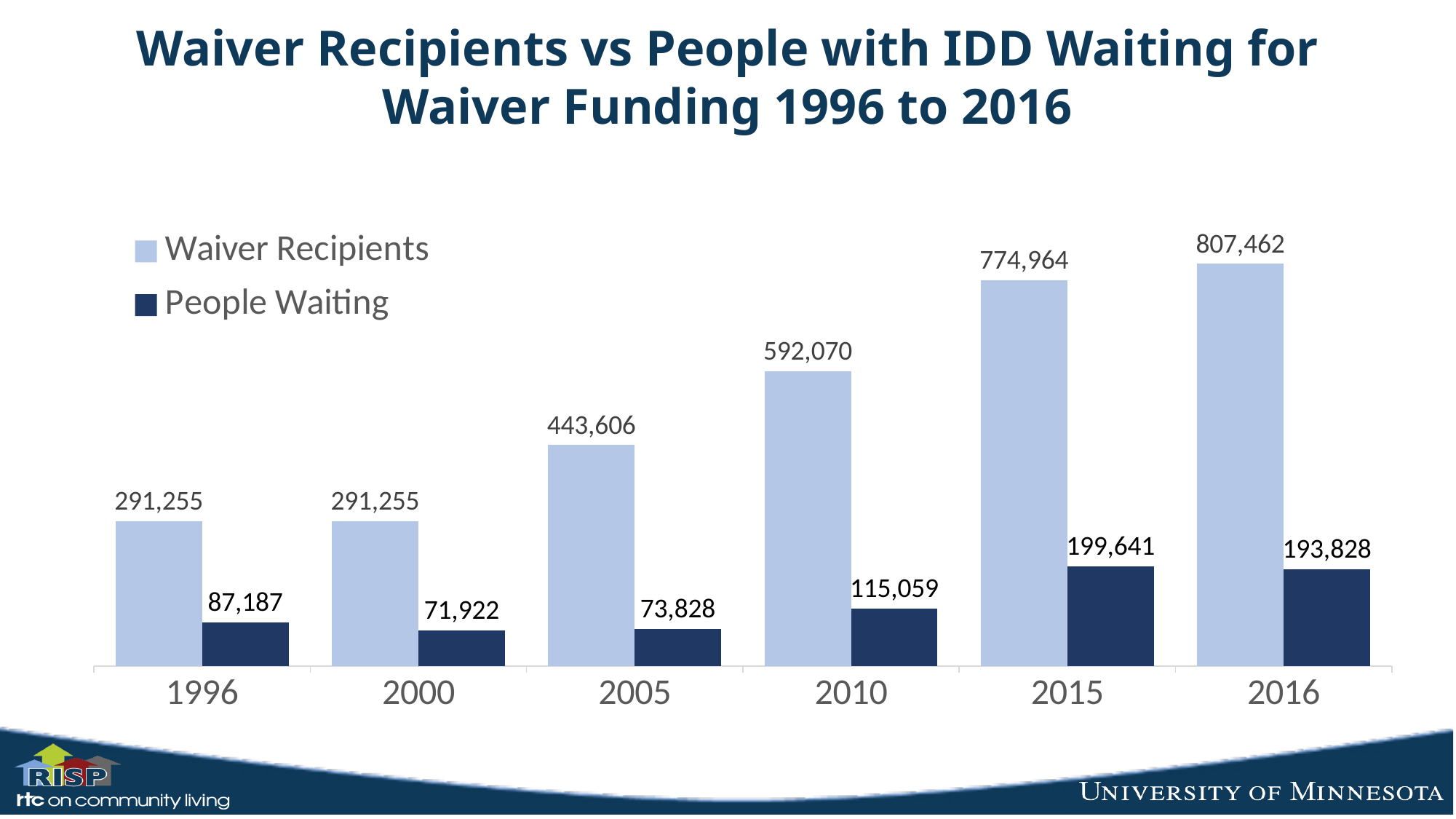
How many series does the legend list? 2 In which year is the People Waiting value highest? 2015 By how much did People Waiting change from 2015 to 2016? 5,813 What is the difference between Waiver Recipients and People Waiting in 2016? 613,634 What is the value for Waiver Recipients in 2016? 807,462 Which is larger: People Waiting in 1996 or People Waiting in 2005? People Waiting in 1996 In which year is the People Waiting value lowest? 2000 How many years are shown on the x axis? 6 What kind of chart is shown on the slide? Bar chart Do the Waiver Recipients values rise or fall from 2000 to 2016? Rise How many People Waiting were there in 2000? 71,922 What is the value for Waiver Recipients in 2010? 592,070